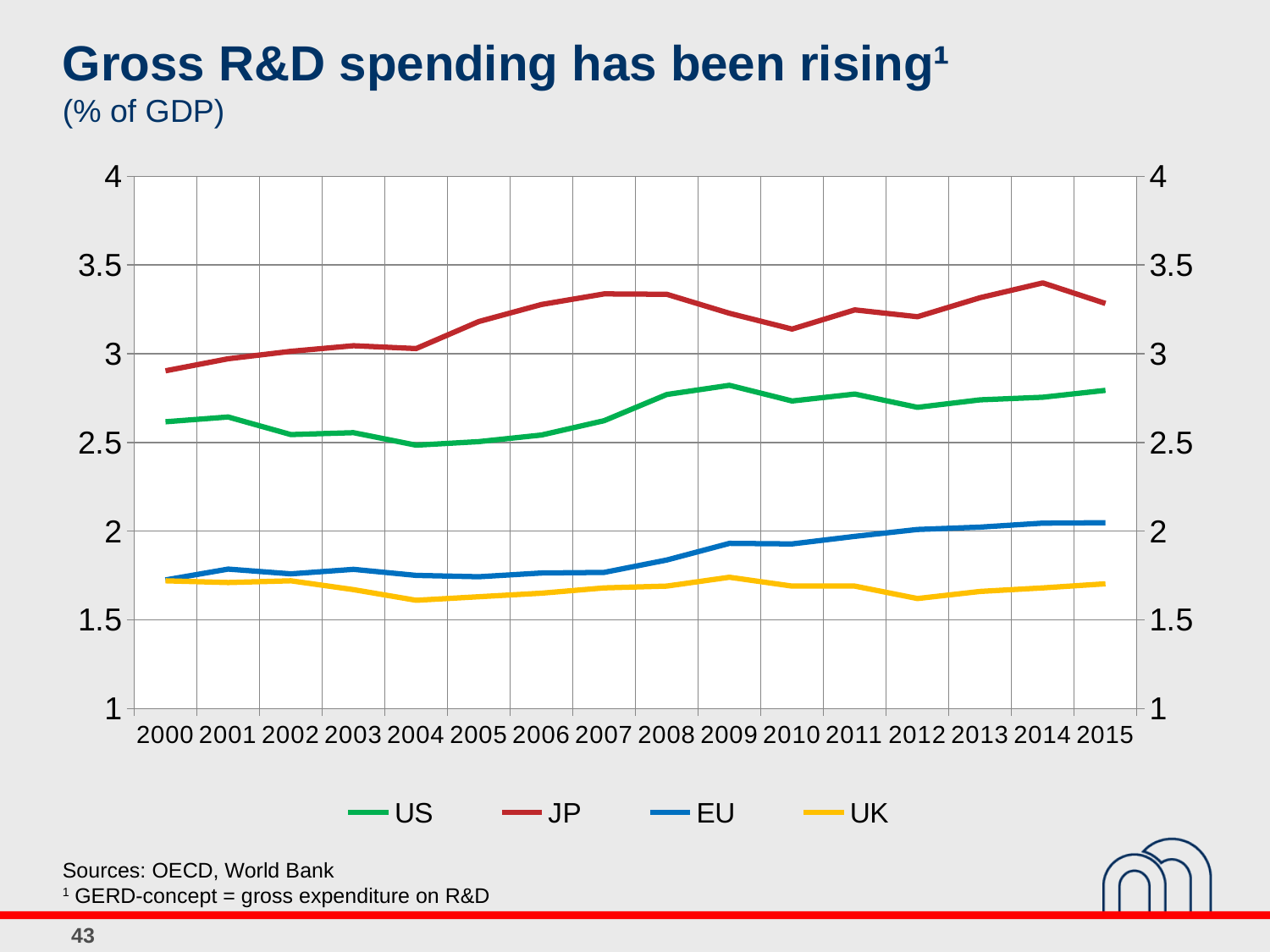
What kind of chart is shown on the slide? line chart What colour is the line for JP? red Is the value for UK in 2012 greater or less than 2? less Which series has the highest R&D spending as a share of GDP throughout the period? JP Which is larger in 2015, the value for EU or the value for UK? EU Does the EU series rise or fall between 2000 and 2015? rise How many series does the legend list? 4 Which series has the lowest R&D spending as a share of GDP in 2015? UK Is the value for JP in 2014 greater or less than 3? greater How many years are shown along the x axis? 16 Is the value for EU in 2015 greater or less than 2? greater